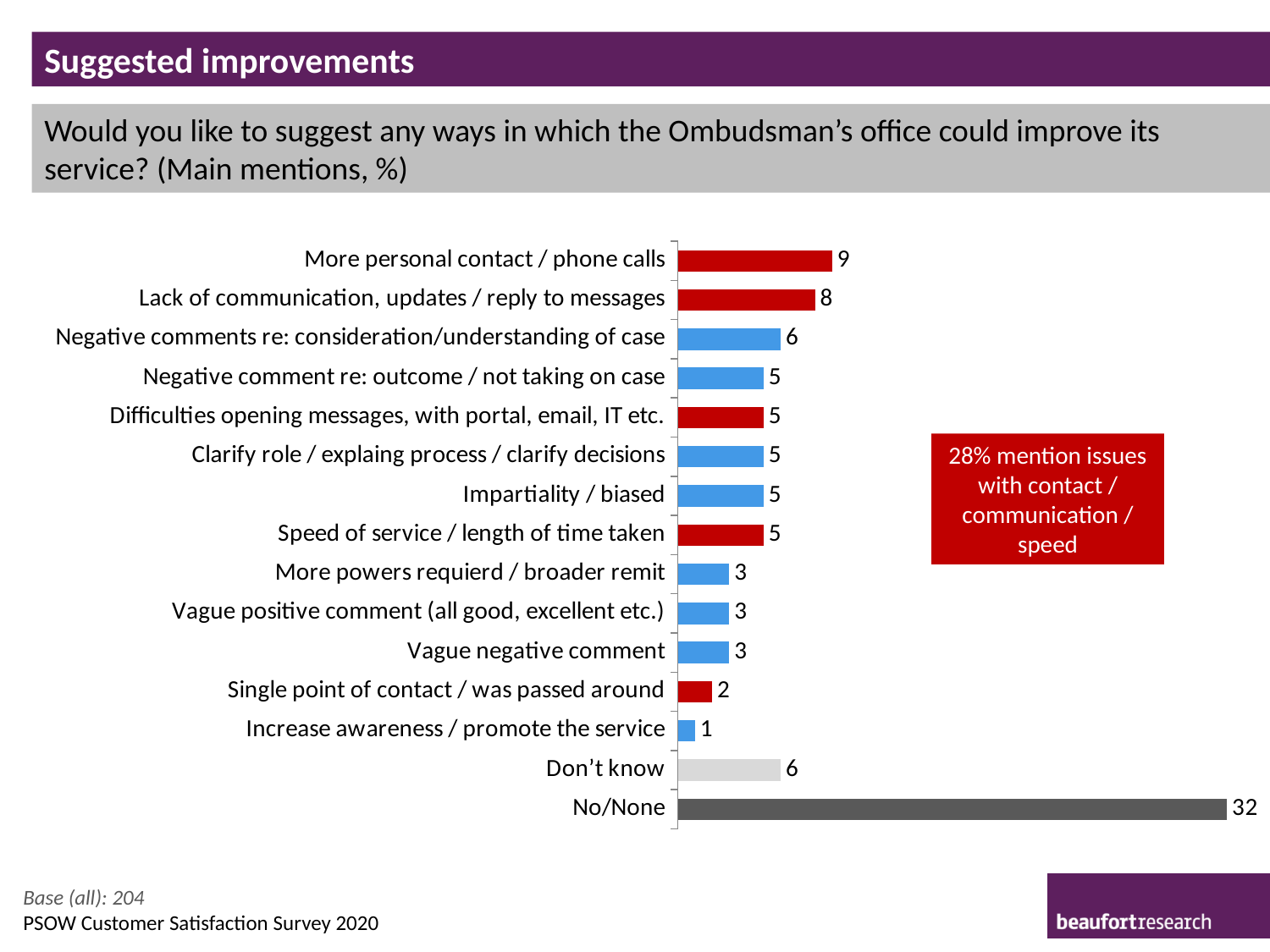
What percentage does the red text box say mention issues with contact / communication / speed? 28% What is the value for "No/None"? 32 Which category has the highest value? No/None What is the difference between the values for "Single point of contact / was passed around" and "Increase awareness / promote the service"? 1 How many categories are shown in the chart? 15 Which is larger, the value for "Lack of communication, updates / reply to messages" or the value for "Negative comments re: consideration/understanding of case"? Lack of communication, updates / reply to messages What is the value for "Increase awareness / promote the service"? 1 Which category has the lowest value? Increase awareness / promote the service What is the value for "More personal contact / phone calls"? 9 What is the value for "Don't know"? 6 What kind of chart is shown on the slide? Bar chart What is the difference between the values for "No/None" and "More personal contact / phone calls"? 23